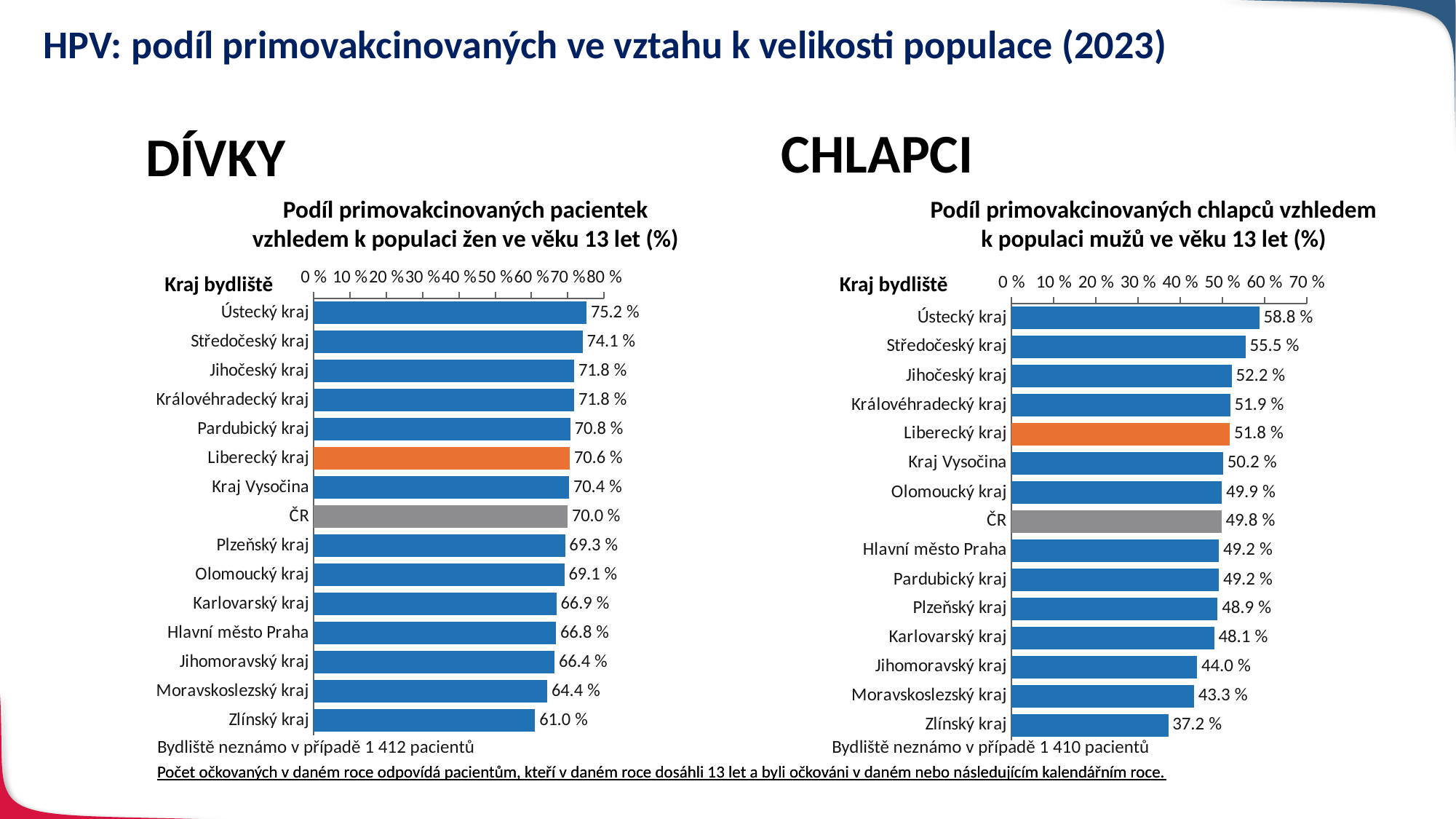
In the CHLAPCI chart, what is the value for Zlínský kraj? 37.2 % In the CHLAPCI chart, which region has the highest value? Ústecký kraj In the DÍVKY chart, what is the value for Liberecký kraj? 70.6 % In the CHLAPCI chart, which region's bar is coloured orange? Liberecký kraj In the DÍVKY chart, is the value for Středočeský kraj greater or less than 70 %? greater What type of chart is the DÍVKY chart? Bar chart In the CHLAPCI chart, which is larger: Jihomoravský kraj or Moravskoslezský kraj? Jihomoravský kraj In the DÍVKY chart, what is the difference between Ústecký kraj and Zlínský kraj? 14.2 % In the CHLAPCI chart, what is the difference between Ústecký kraj and ČR? 9.0 % In the DÍVKY chart, which region has the lowest value? Zlínský kraj How many regions (including ČR) are listed in the CHLAPCI chart? 15 In the DÍVKY chart, what is the value for ČR? 70.0 %